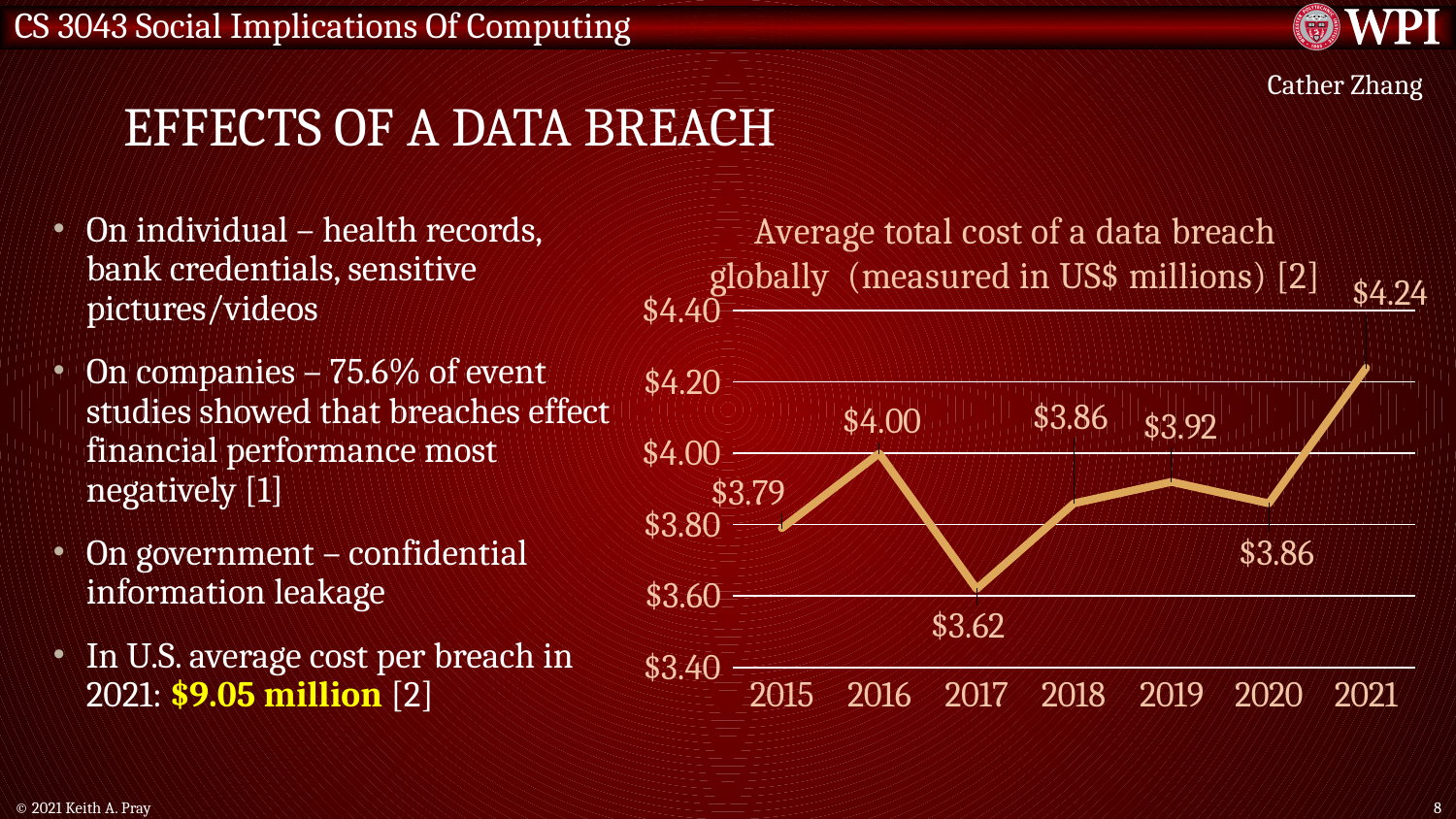
Does the value rise or fall from 2020 to 2021? Rise What is the average total cost of a data breach globally in 2015? $3.79 Which year has the highest average total cost of a data breach? 2021 What is the difference between the 2016 value and the 2017 value? $0.38 What is the value shown for 2017? $3.62 What is the difference between the 2021 value and the 2020 value? $0.38 Which year has a higher value, 2016 or 2019? 2016 In what unit are the values on the chart measured, according to the chart title? US$ millions How many years are plotted on the chart? 7 Which year has the lowest average total cost of a data breach? 2017 What is the average total cost of a data breach globally in 2021? $4.24 What type of chart is shown on the slide? Line chart